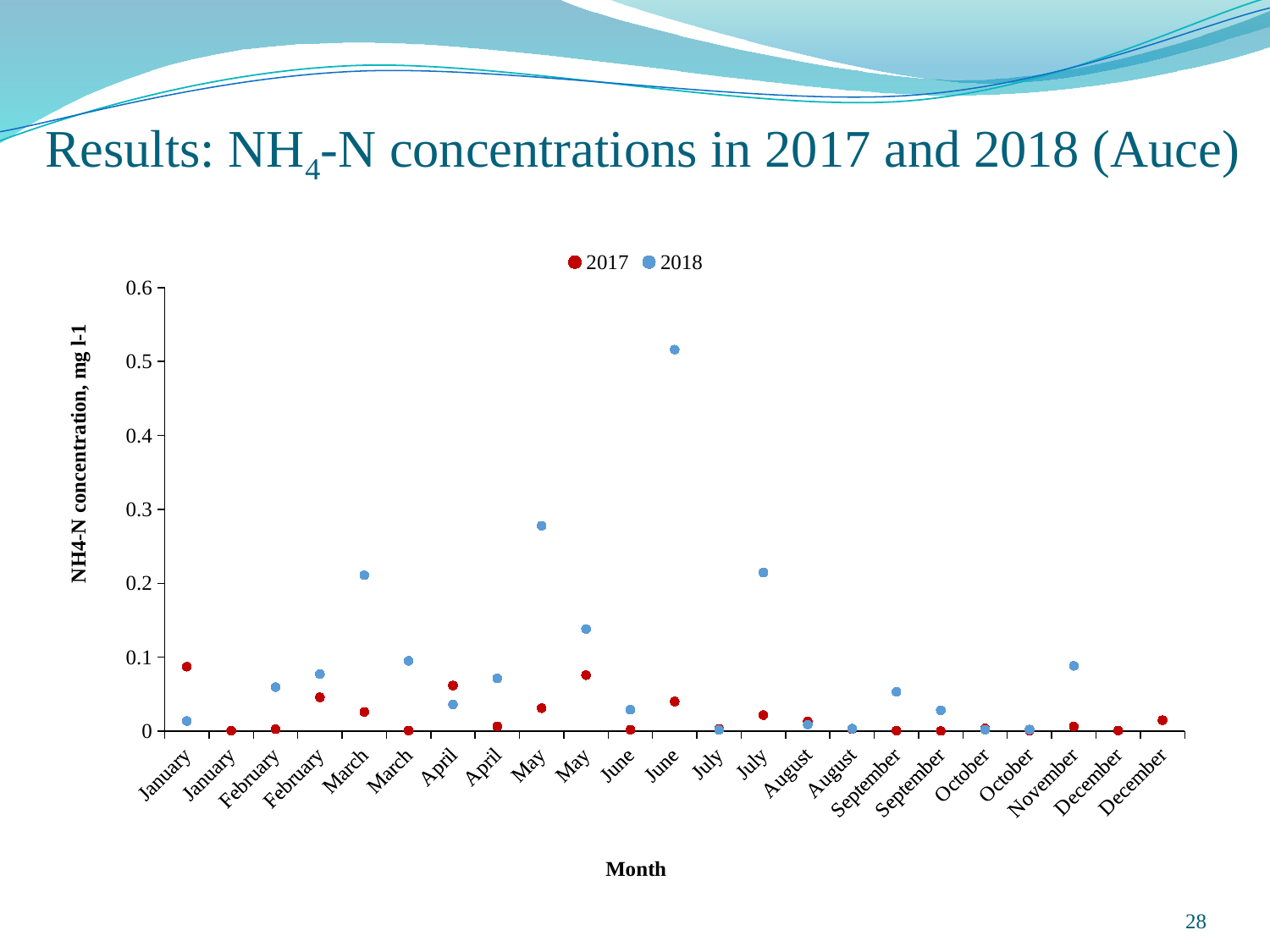
At the first January point, which series has the larger value, 2017 or 2018? 2017 Which series contains the highest point on the chart? 2018 Which two series are listed in the legend? 2017 and 2018 What is the title of the vertical axis? NH4-N concentration, mg l-1 Is the highest 2018 value (in June) greater or less than 0.4? greater How many series does the legend list? 2 Is the 2018 value at the first May point greater or less than 0.2? greater Is the 2017 value at the first January point greater or less than 0.1? less What kind of chart is shown on the slide? scatter chart At the second June point, which series has the larger value, 2017 or 2018? 2018 In which month does the 2018 series reach its highest value? June How many month labels are shown along the x axis? 23